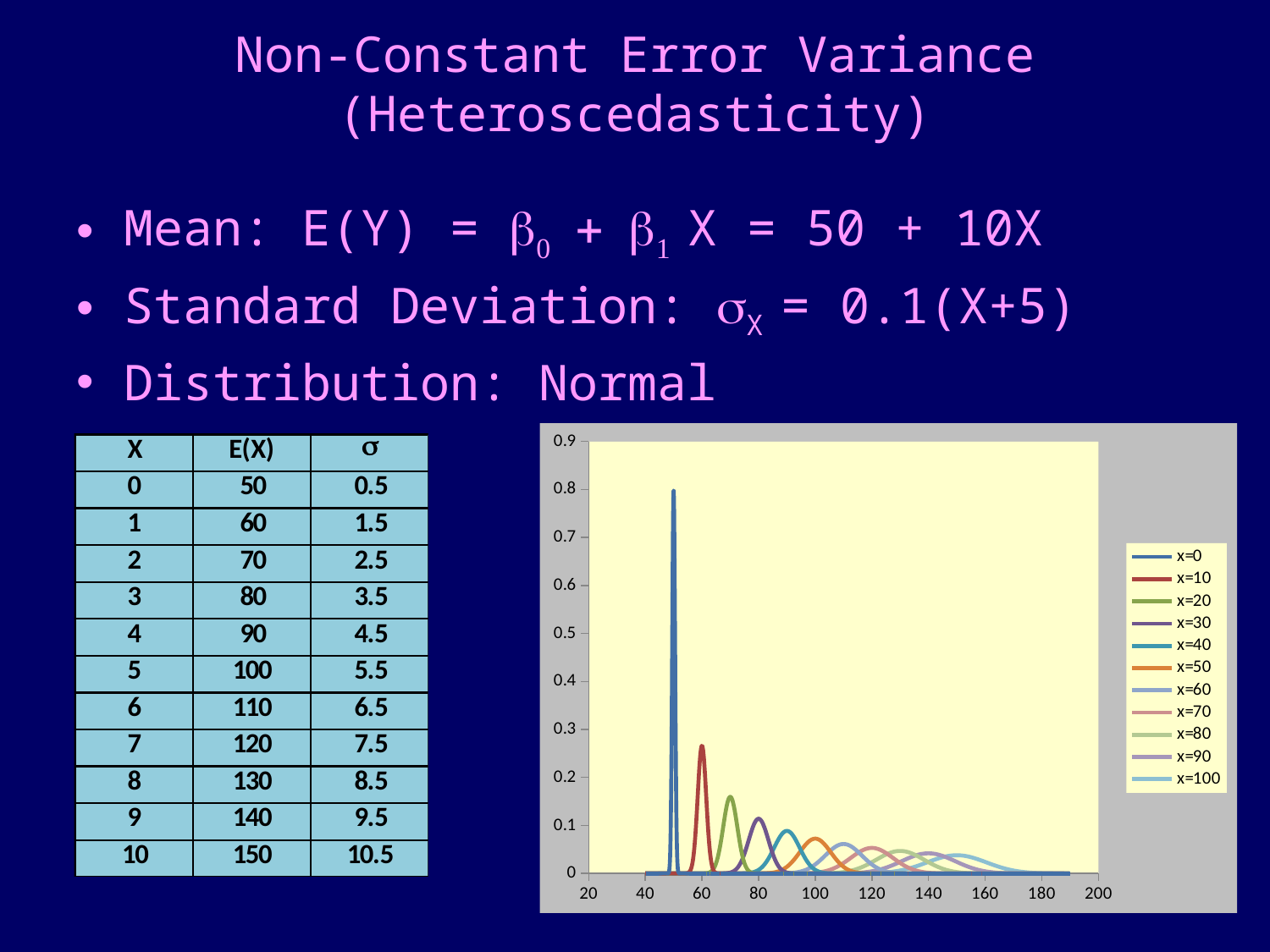
What is the last entry listed in the chart's legend? x=100 Is the peak of the x=20 curve greater or less than 0.2? less How many series does the chart's legend list? 11 What is the highest tick value shown on the chart's vertical axis? 0.9 Is the peak of the x=0 curve greater or less than 0.7? greater Is the peak of the x=10 curve greater or less than 0.3? less As the series go from x=0 to x=100, do the peak heights of the curves rise or fall? fall Which series has the lowest peak in the chart? x=100 Which series has the highest peak in the chart? x=0 Which curve has a higher peak, x=0 or x=10? x=0 Which curve has a higher peak, x=30 or x=60? x=30 What kind of chart is shown on the slide? line chart